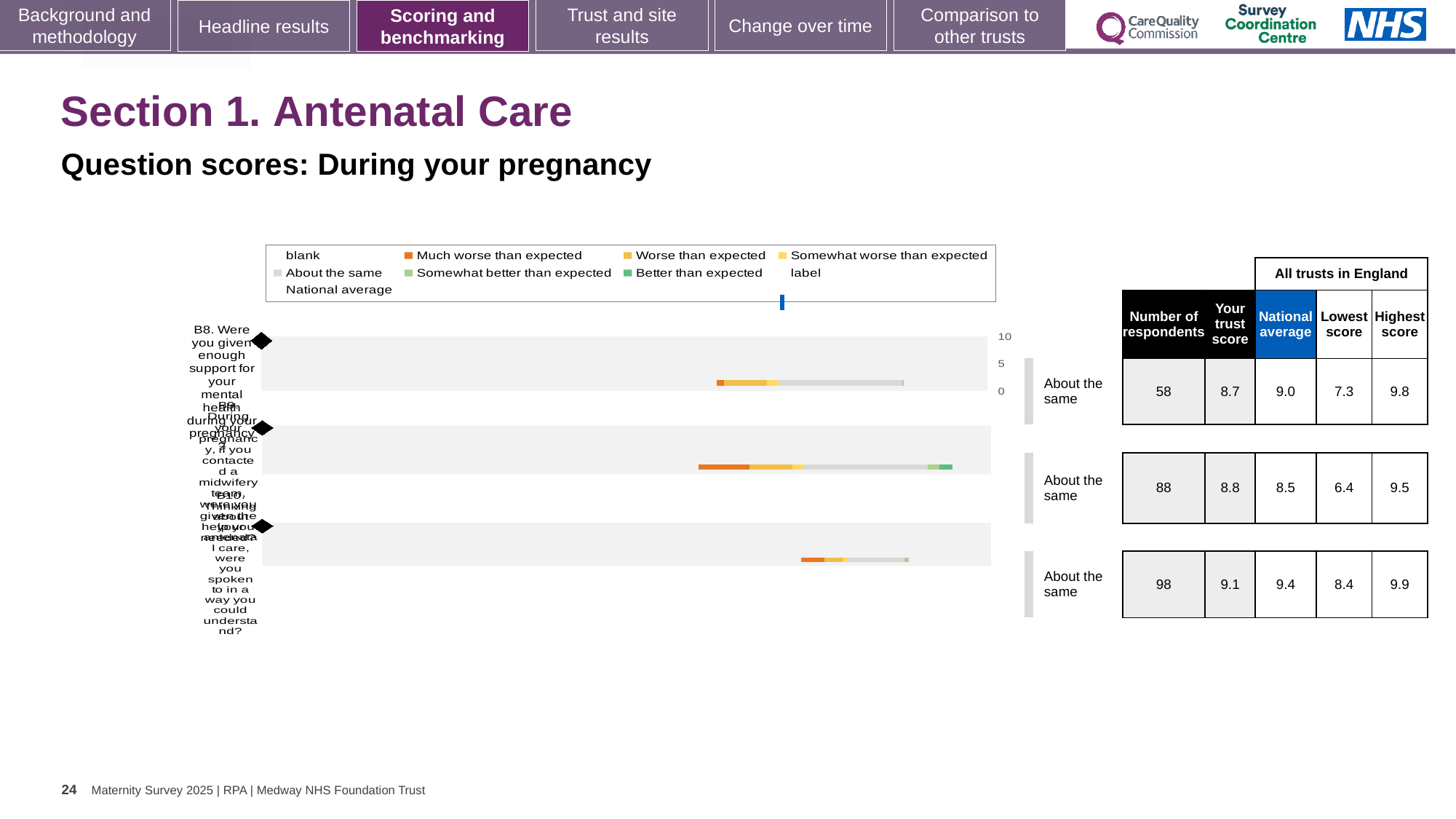
Which row of the table has the highest number of respondents? the third row (98) In the chart legend, what colour represents 'Much worse than expected'? orange What kind of chart is shown on the slide? bar chart What is the number of respondents for the first row (B8, support for your mental health during pregnancy)? 58 What is the national average for the first row (B8, support for your mental health during pregnancy)? 9.0 How many question rows (bars) are plotted in the chart? 3 What is the difference between the highest score and the lowest score for the first row (B8)? 2.5 What is the trust score for the first row (B8, support for your mental health during pregnancy)? 8.7 In the chart legend, what colour represents 'Better than expected'? green For the second row of the table, which is larger: the trust score or the national average? the trust score (8.8) What is the highest score across all trusts in England for the third row of the table? 9.9 What benchmark category is shown for all three questions on the slide? About the same